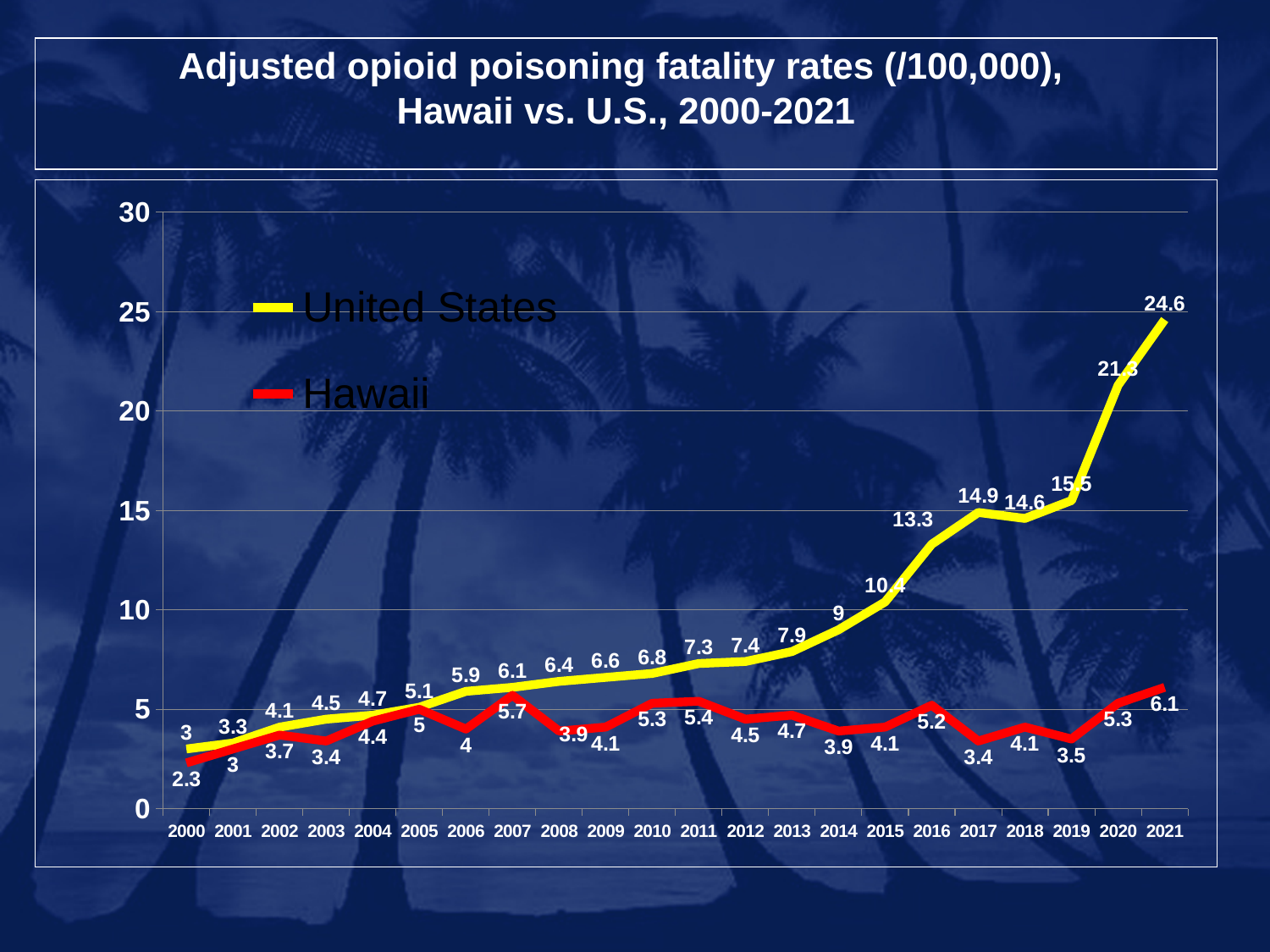
In which year is the Hawaii rate lowest? 2000 What is the difference between the United States and Hawaii values in 2021? 18.5 In which year is the United States rate highest? 2021 Is the United States value for 2016 greater or less than 10? greater How many years are shown on the x axis? 22 What kind of chart is shown? Line chart What is the Hawaii value for 2017? 3.4 What is the Hawaii value for 2000? 2.3 Does the United States rate generally rise or fall from 2000 to 2021? Rise In 2007, which is larger: the United States value or the Hawaii value? United States How many series does the legend list? 2 What is the United States value for 2021? 24.6